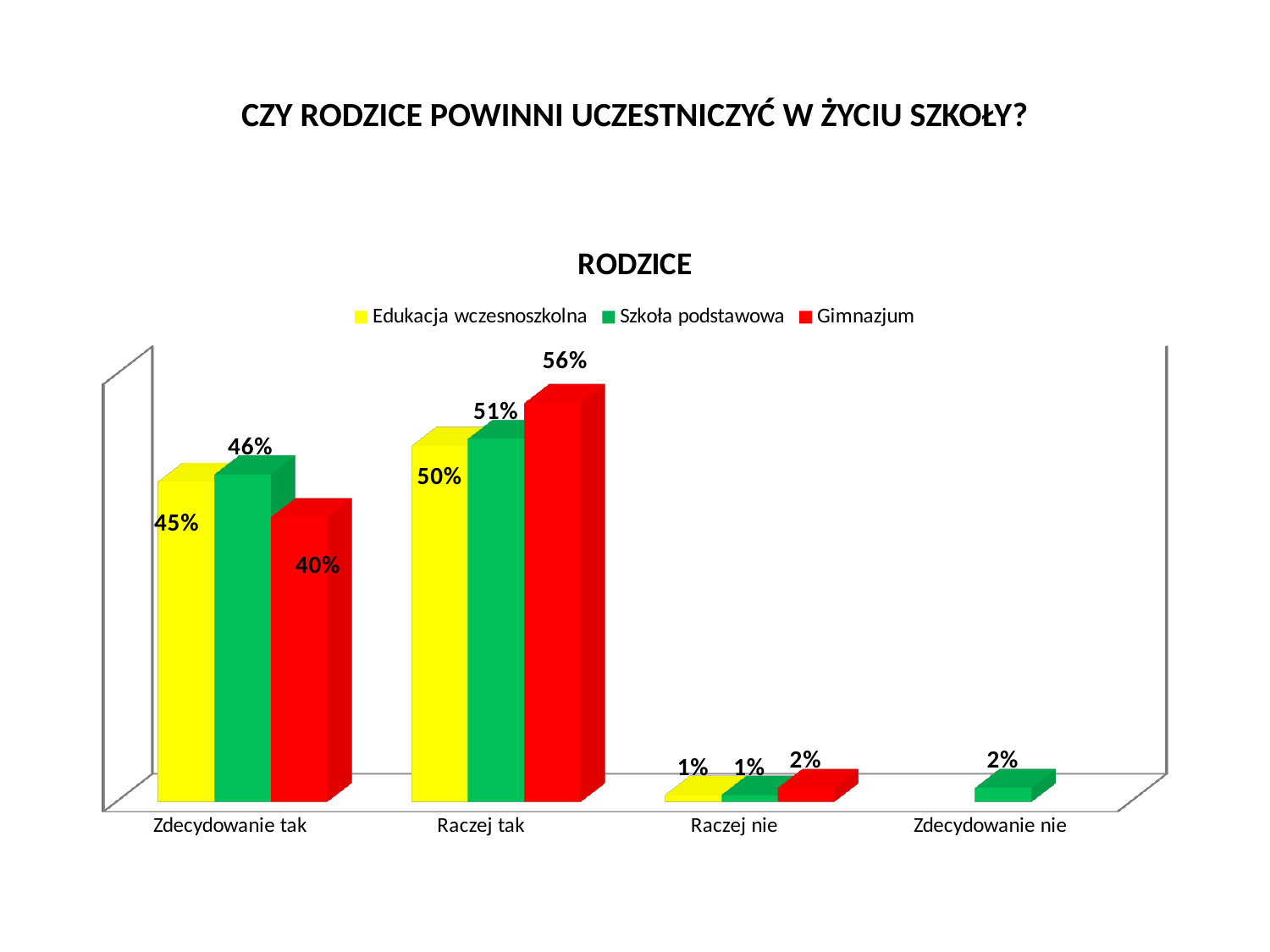
What is the value for Gimnazjum in the Zdecydowanie tak category? 40% Which series has the highest value in the Raczej tak category? Gimnazjum Which is larger for Szkoła podstawowa: Zdecydowanie tak or Raczej tak? Raczej tak How many categories are shown on the x axis? 4 What kind of chart is shown on the slide? bar chart How many series does the legend list? 3 What is the value for Szkoła podstawowa in the Zdecydowanie tak category? 46% What is the difference between the Gimnazjum values for Raczej tak and Zdecydowanie tak? 16% Which series has the lowest value in the Zdecydowanie tak category? Gimnazjum What is the title of the chart? RODZICE What is the value for Edukacja wczesnoszkolna in the Raczej tak category? 50% What is the value for Gimnazjum in the Raczej nie category? 2%